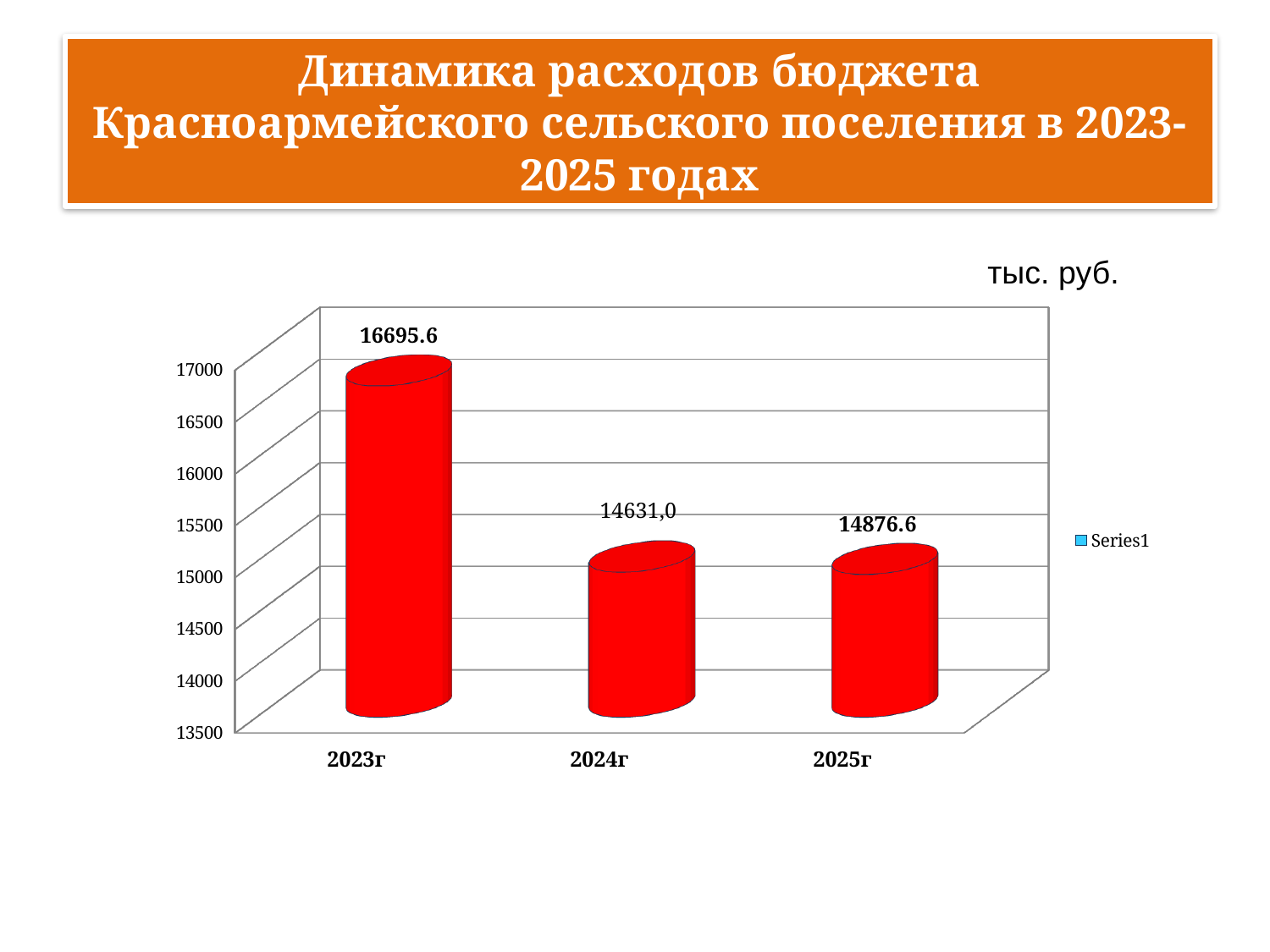
What is the value for 2024г? 14631,0 Which is larger, the value for 2023г or the value for 2025г? 2023г What kind of chart is shown on the slide? bar chart What is the value for 2025г? 14876.6 How many years are shown on the chart? 3 Is the value for 2024г greater or less than 15000? less What is the value for 2023г? 16695.6 Which year has the lowest value? 2024г What is the difference between the values for 2025г and 2024г? 245.6 Which year has the highest value? 2023г What unit is indicated above the chart? тыс. руб. What is the difference between the values for 2023г and 2024г? 2064.6